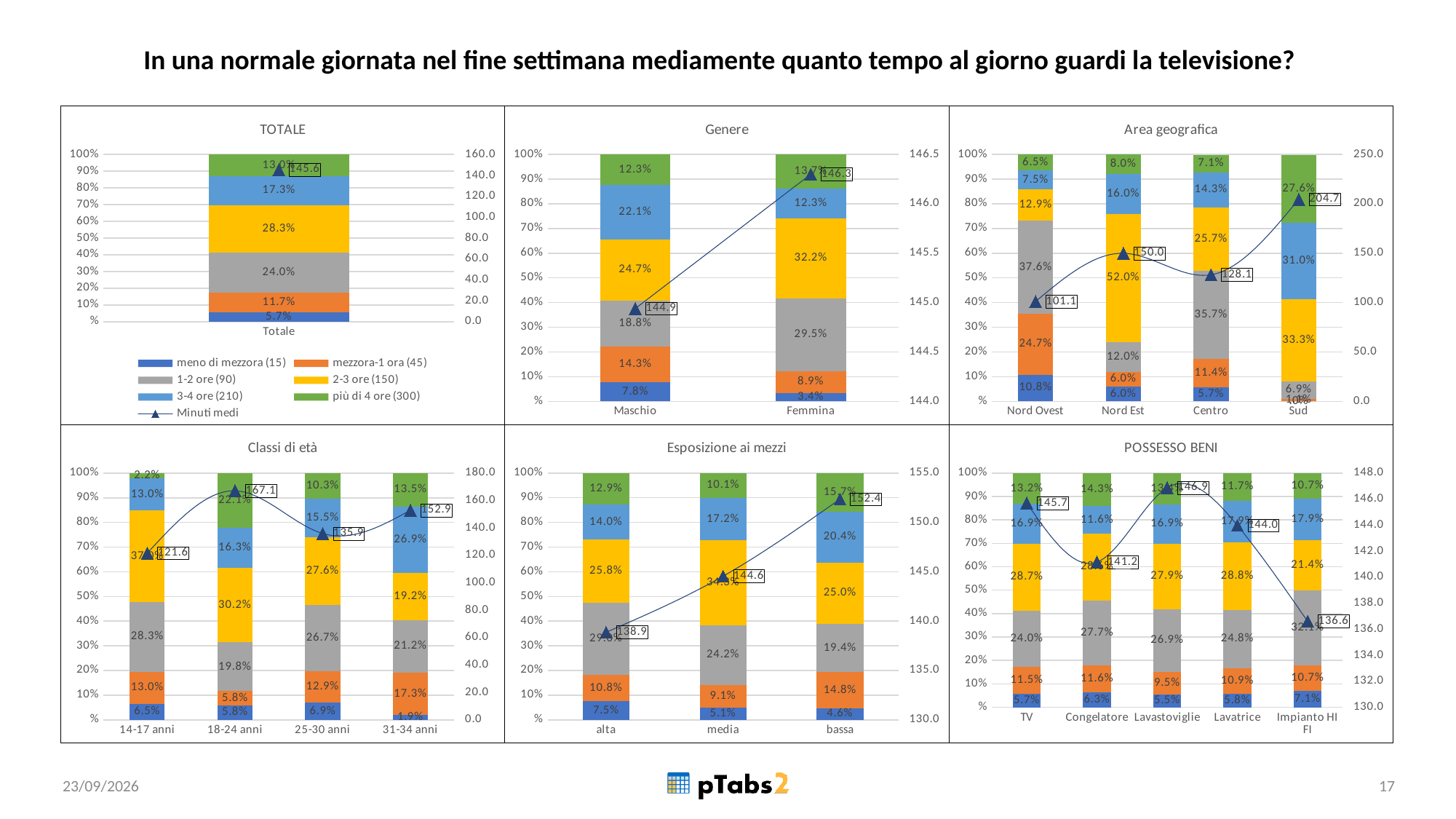
In the Area geografica chart, which area has the highest 'Minuti medi' value? Sud In the TOTALE chart, what is the value for '2-3 ore (150)'? 28.3% How many entries does the legend on the slide list? 7 In the TOTALE chart, what is the 'Minuti medi' value for Totale? 145.6 In the Classi di età chart, which age class has the lowest 'Minuti medi' value? 14-17 anni In the POSSESSO BENI chart, what is the 'Minuti medi' value for Impianto HI FI? 136.6 In the Esposizione ai mezzi chart, does the 'Minuti medi' value rise or fall from alta to bassa? rise In the Genere chart, what is the 'Minuti medi' value for Femmina? 146.3 In the Classi di età chart, how many age classes are shown on the x axis? 4 In the Genere chart, what is the difference between the '2-3 ore (150)' values for Femmina and Maschio? 7.5% In the Esposizione ai mezzi chart, which is larger, the '3-4 ore (210)' value for bassa or for alta? bassa In the Area geografica chart, what is the '2-3 ore (150)' value for Nord Est? 52.0%